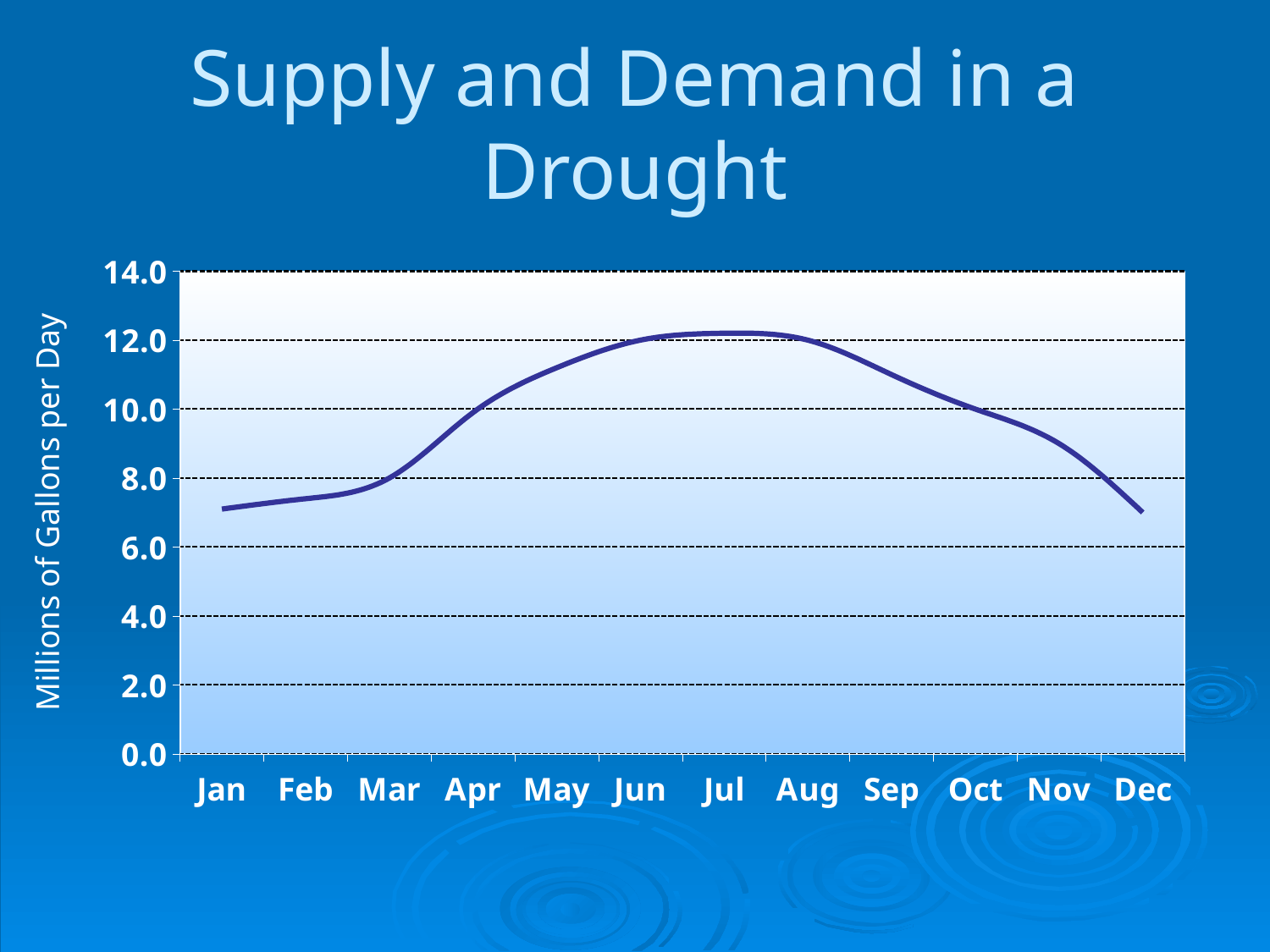
Is the value for Jan greater or less than 8.0? less Is the value for Jun greater or less than 10.0? greater Which month has the larger value, Jul or Jan? Jul Does the line rise or fall from Jan to Jul? rise Is the value for Nov greater or less than 10.0? less What kind of chart is shown on the slide? line chart How many months are plotted along the x axis? 12 Which month has the larger value, Mar or Jun? Jun In which month does the line reach its highest value? Jul What is the label on the vertical axis? Millions of Gallons per Day